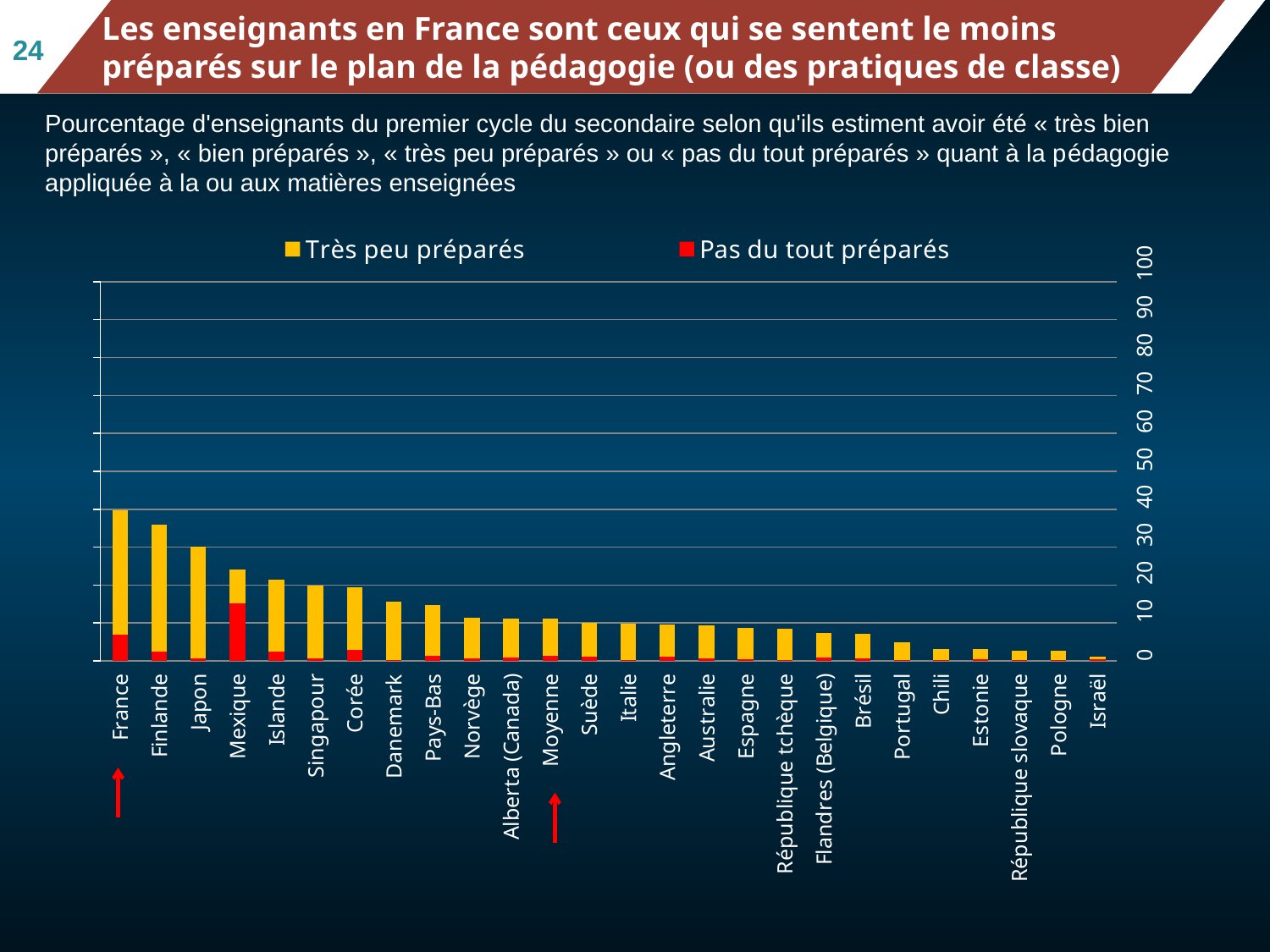
Which colour represents the series "Pas du tout préparés" in the legend? Red Is the total value for France greater or less than 30? greater What kind of chart is shown on the slide? Stacked bar chart How many countries or regions are shown on the x axis? 26 Is the total value for Mexique greater or less than 30? less Which country has the highest total bar? France Is the total value for Moyenne greater or less than 20? less Which country has the lowest total bar? Israël How many series does the legend list? 2 Which has a larger total bar, France or Finlande? France Do the total bar values rise or fall from left to right along the x axis? Fall